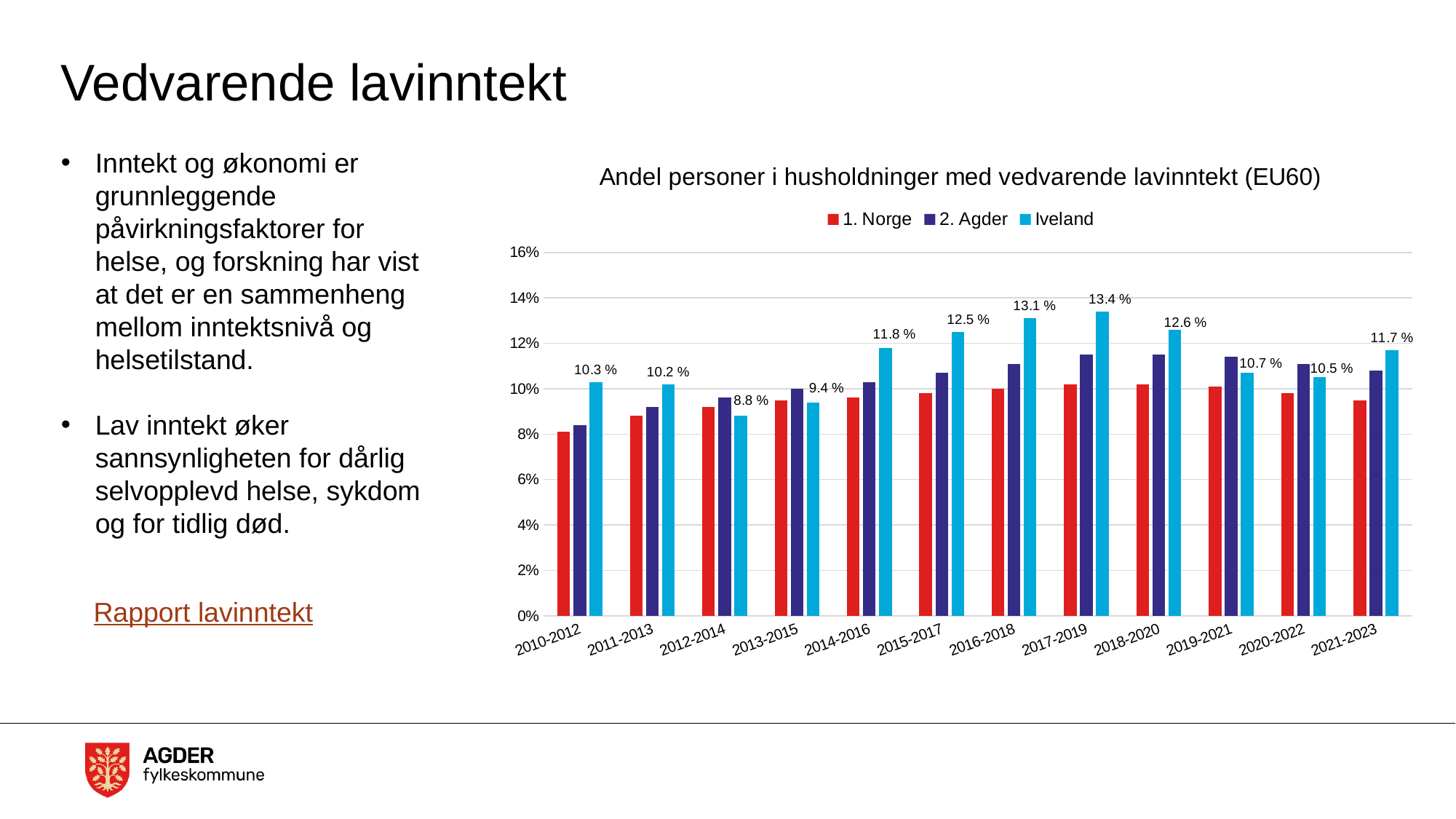
Is the value for 1. Norge in 2010-2012 greater or less than 10%? less In which period is the Iveland value highest? 2017-2019 In which period is the Iveland value lowest? 2012-2014 How many series does the legend list? 3 What is the value for Iveland in 2021-2023? 11.7 % Is the value for 2. Agder in 2017-2019 greater or less than 10%? greater How many periods are shown on the x axis? 12 What is the difference between the Iveland values for 2017-2019 and 2012-2014? 4.6 percentage points What kind of chart is shown on the slide? Bar chart Which is larger for Iveland: the value for 2014-2016 or the value for 2015-2017? 2015-2017 What is the value for Iveland in 2012-2014? 8.8 % What is the value for Iveland in 2017-2019? 13.4 %